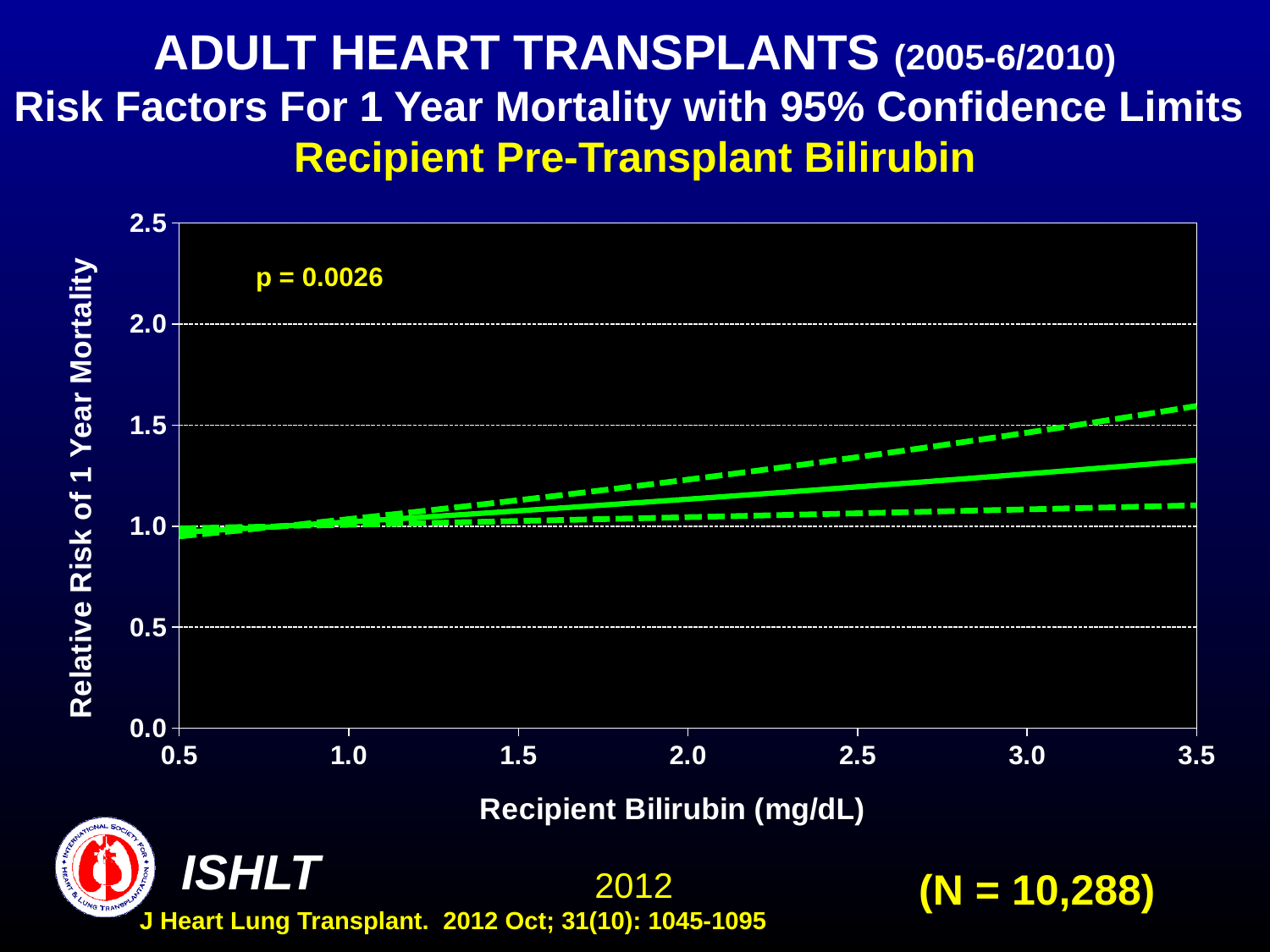
At a recipient bilirubin of 3.5 mg/dL, which is larger: the upper dashed confidence limit or the solid relative risk line? the upper dashed confidence limit Is the relative risk (solid line) at a recipient bilirubin of 3.5 mg/dL greater or less than 1.0? greater Is the upper 95% confidence limit (upper dashed line) at a recipient bilirubin of 3.5 mg/dL greater or less than 2.0? less What p-value is printed on the chart? p = 0.0026 What kind of chart is shown on the slide? line chart Is the relative risk (solid line) at a recipient bilirubin of 2.0 mg/dL greater or less than 1.5? less Does the relative risk of 1 year mortality rise or fall as recipient bilirubin increases from 0.5 to 3.5 mg/dL? rise What is the highest value shown on the y axis of the chart? 2.5 How many lines are plotted on the chart? 3